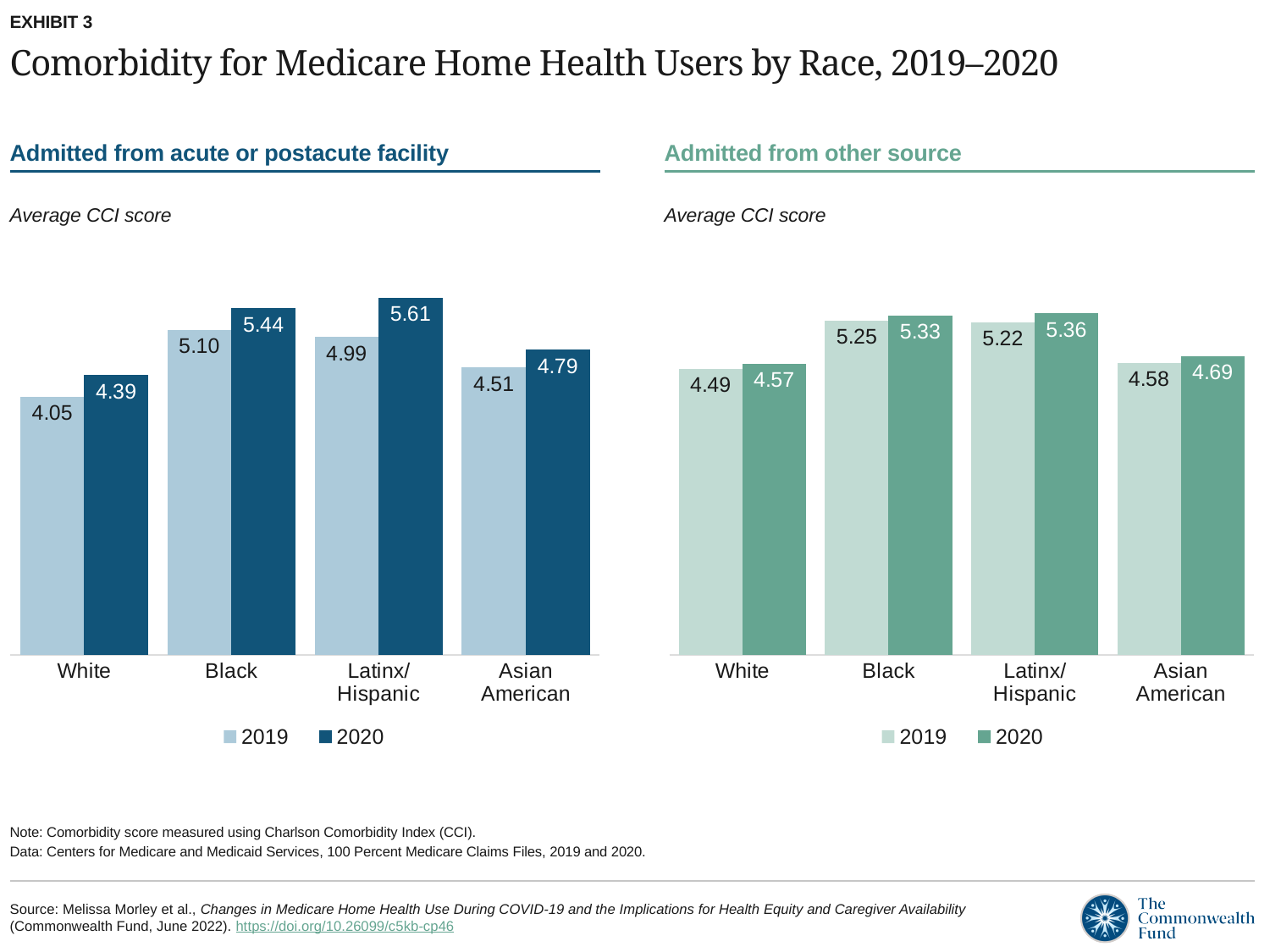
In the 'Admitted from acute or postacute facility' chart, what is the average CCI score for Black users in 2020? 5.44 What type of chart is used for 'Admitted from other source'? Bar chart In the 'Admitted from other source' chart, which race group has the highest 2020 average CCI score? Latinx/Hispanic How many series does the legend of the 'Admitted from acute or postacute facility' chart list? 2 In the 'Admitted from other source' chart, what is the difference between the 2020 and 2019 average CCI scores for Asian American users? 0.11 In the 'Admitted from acute or postacute facility' chart, which race group has the highest 2020 average CCI score? Latinx/Hispanic In the 'Admitted from acute or postacute facility' chart, which is larger: the 2019 score for Black users or the 2019 score for Latinx/Hispanic users? Black (5.10) In the 'Admitted from other source' chart, what is the average CCI score for White users in 2019? 4.49 How many race categories are shown in the 'Admitted from other source' chart? 4 What are the two series listed in the legend of the 'Admitted from other source' chart? 2019 and 2020 In the 'Admitted from acute or postacute facility' chart, which race group has the lowest 2019 average CCI score? White In the 'Admitted from acute or postacute facility' chart, what is the difference between the 2020 and 2019 average CCI scores for Latinx/Hispanic users? 0.62